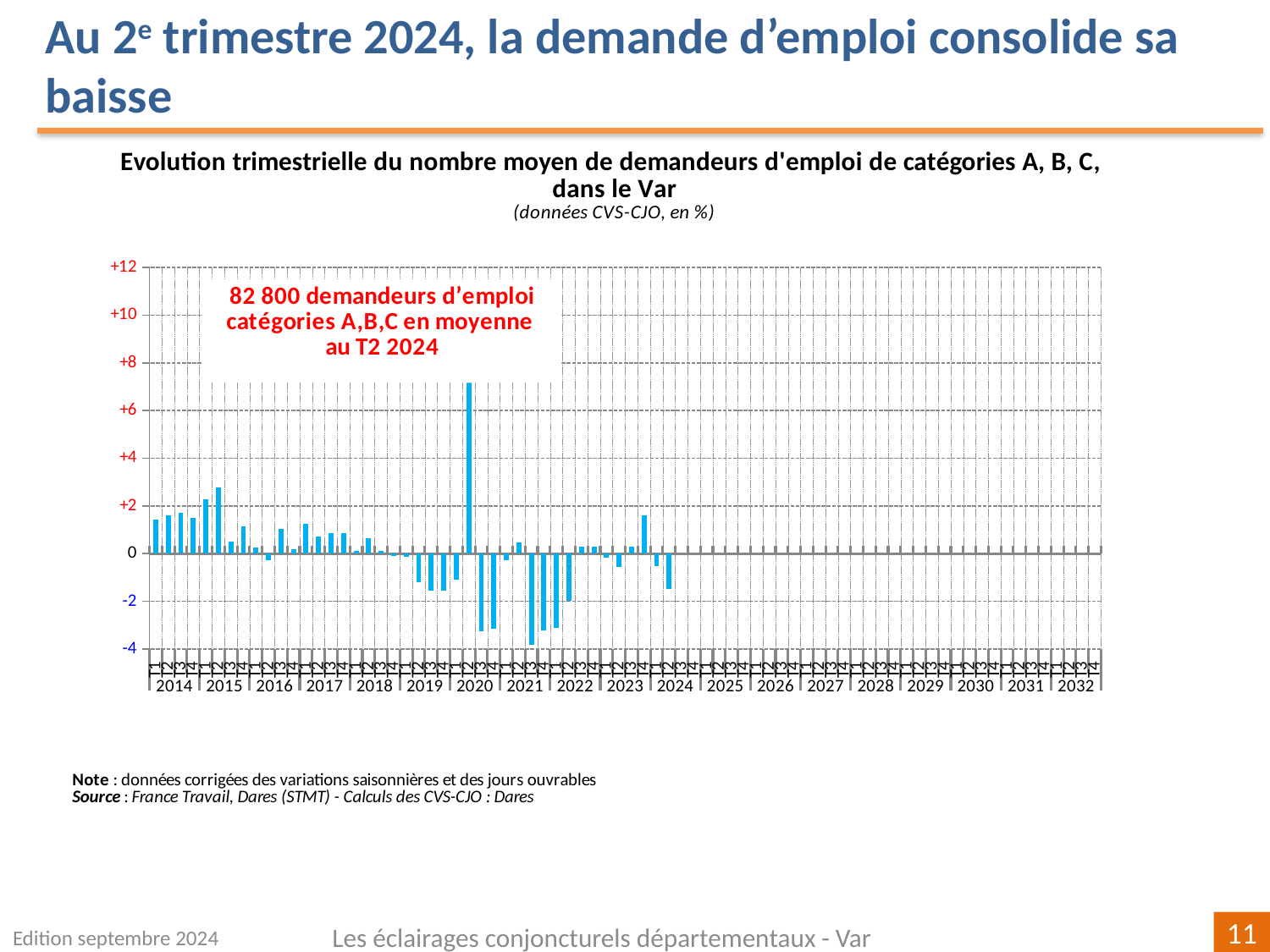
How many years are labelled along the x axis of the chart? 19 Is the value for T2 2020 greater or less than +6? greater In what unit are the data on the chart expressed, according to the subtitle? % According to the annotation on the chart, how many job seekers in categories A, B, C were there on average in T2 2024? 82 800 What kind of chart is shown on the slide? Bar chart Is the value for T2 2024 greater or less than 0? less In which quarter does the chart show its lowest value? T3 2021 In which quarter does the chart show its highest value? T2 2020 Is the value for T1 2021 greater or less than -2? greater Which is larger, the value for T2 2020 or the value for T2 2015? T2 2020